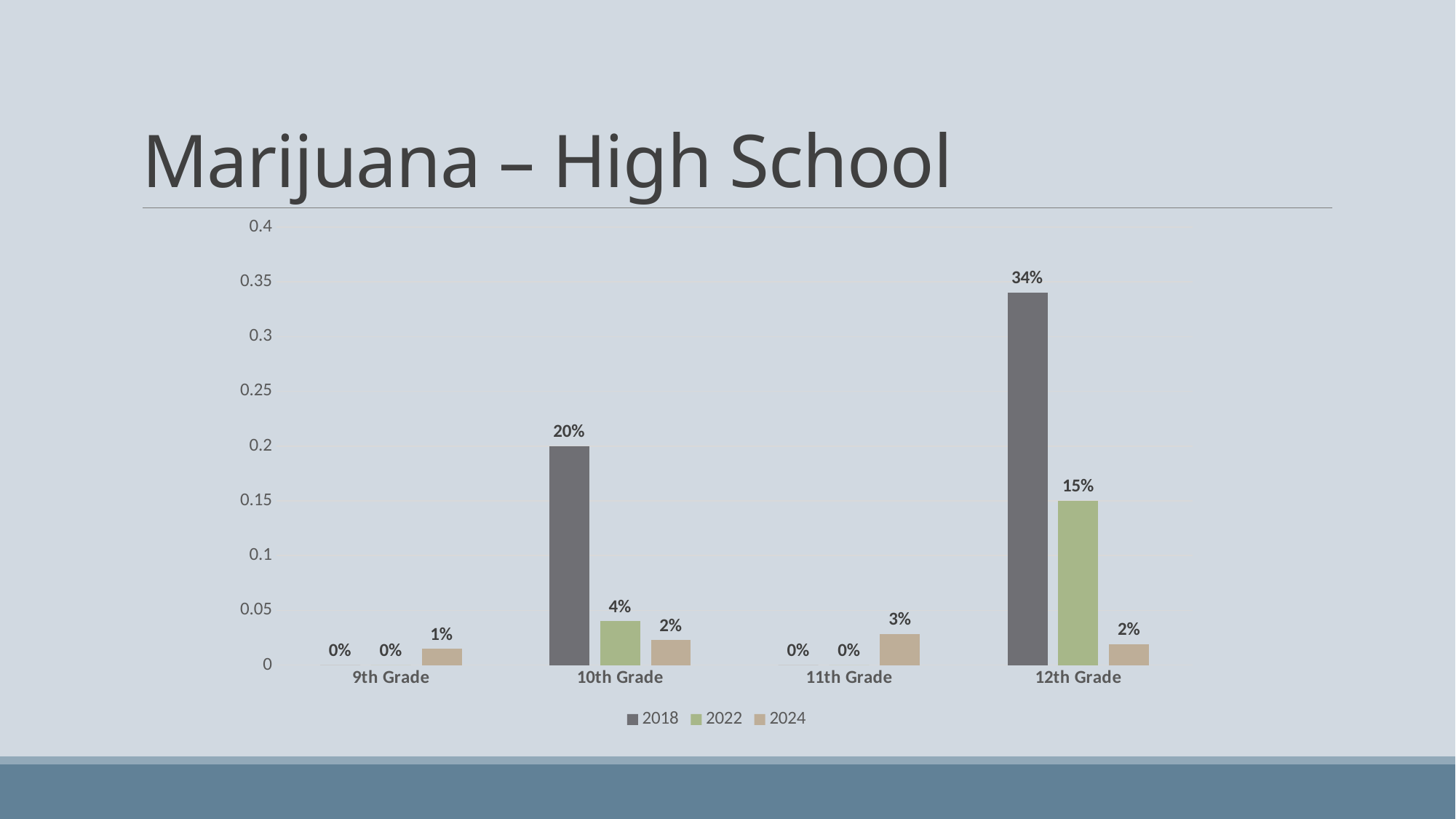
Which grade has the lowest value in the 2024 series? 9th Grade What is the difference between the 2018 and 2022 values for 12th Grade? 19% What is the value for 12th Grade in the 2018 series? 34% What is the value for 9th Grade in the 2024 series? 1% How many grade categories are shown on the x axis? 4 What is the value for 11th Grade in the 2024 series? 3% What kind of chart is shown on the slide? Bar chart Which is larger for 10th Grade: the 2018 value or the 2024 value? 2018 What is the value for 10th Grade in the 2022 series? 4% Which grade has the highest value in the 2018 series? 12th Grade What is the title of the slide? Marijuana – High School How many series does the legend list? 3